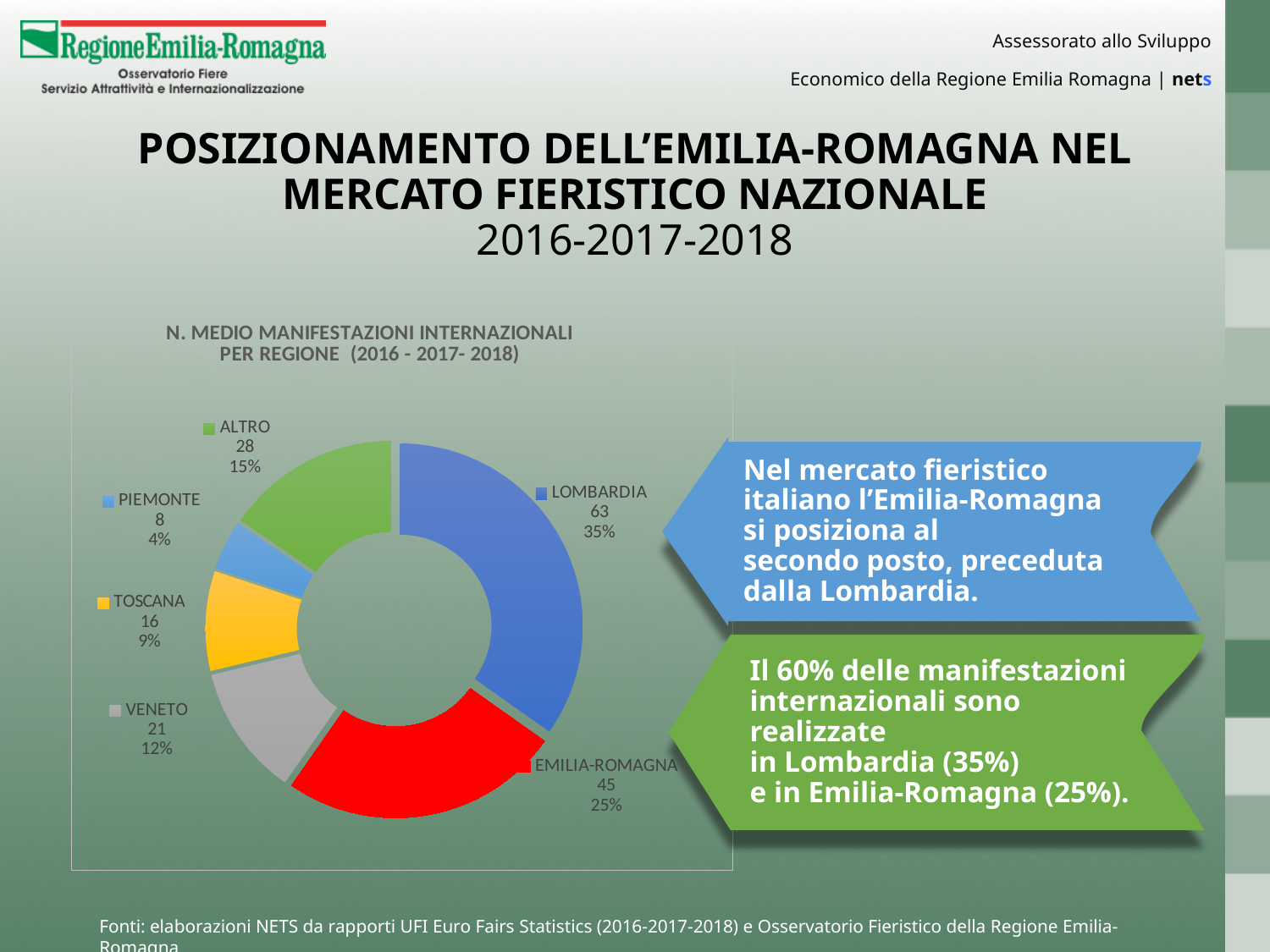
Which is larger, the value for VENETO or the value for TOSCANA? VENETO What is the difference between the values for LOMBARDIA and EMILIA-ROMAGNA? 18 What kind of chart is shown on the slide? Doughnut (pie) chart What is the value for TOSCANA in the chart? 16 What percentage share does VENETO have in the chart? 12% How many categories are shown in the chart? 6 What is the title of the chart? N. MEDIO MANIFESTAZIONI INTERNAZIONALI PER REGIONE (2016 - 2017- 2018) Which region has the lowest value in the chart? PIEMONTE What percentage share does PIEMONTE have in the chart? 4% What is the value for EMILIA-ROMAGNA in the chart? 45 Which region has the highest value in the chart? LOMBARDIA What is the value for LOMBARDIA in the chart? 63